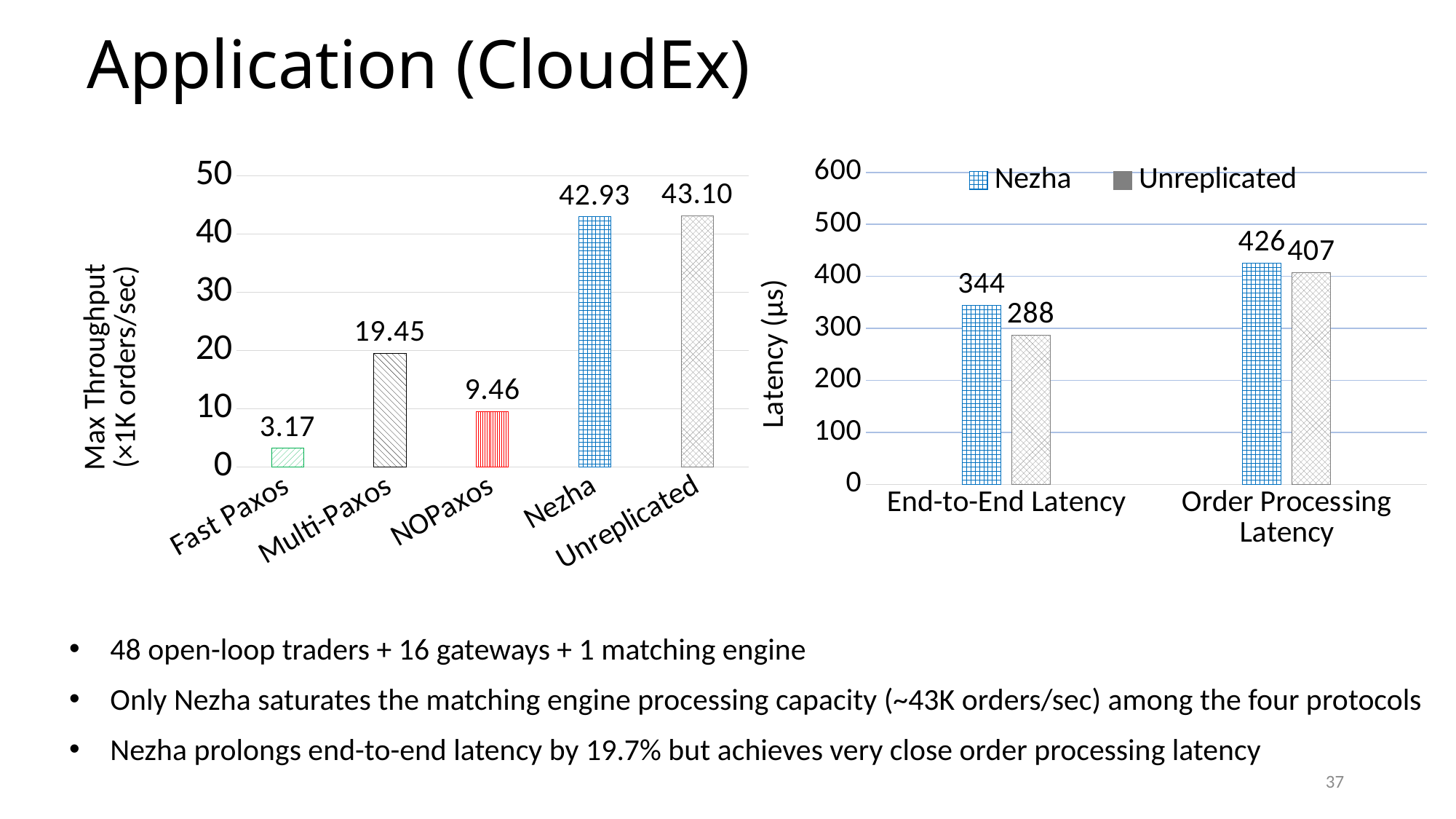
In the left chart (Max Throughput), how many categories are shown on the x axis? 5 What kind of chart is the right chart (Latency)? Bar chart In the left chart (Max Throughput), which category has the lowest value? Fast Paxos In the left chart (Max Throughput), what is the value for Fast Paxos? 3.17 In the right chart (Latency), which is larger for Order Processing Latency: Nezha or Unreplicated? Nezha In the right chart (Latency), what is the difference between the Nezha and Unreplicated values for End-to-End Latency? 56 In the left chart (Max Throughput), is the value for Multi-Paxos greater or less than 10? greater In the right chart (Latency), how many series does the legend list? 2 In the left chart (Max Throughput), what is the value for Multi-Paxos? 19.45 In the left chart (Max Throughput), what is the difference between the Nezha and NOPaxos values? 33.47 In the right chart (Latency), what is the Nezha value for End-to-End Latency? 344 In the right chart (Latency), what is the Unreplicated value for Order Processing Latency? 407